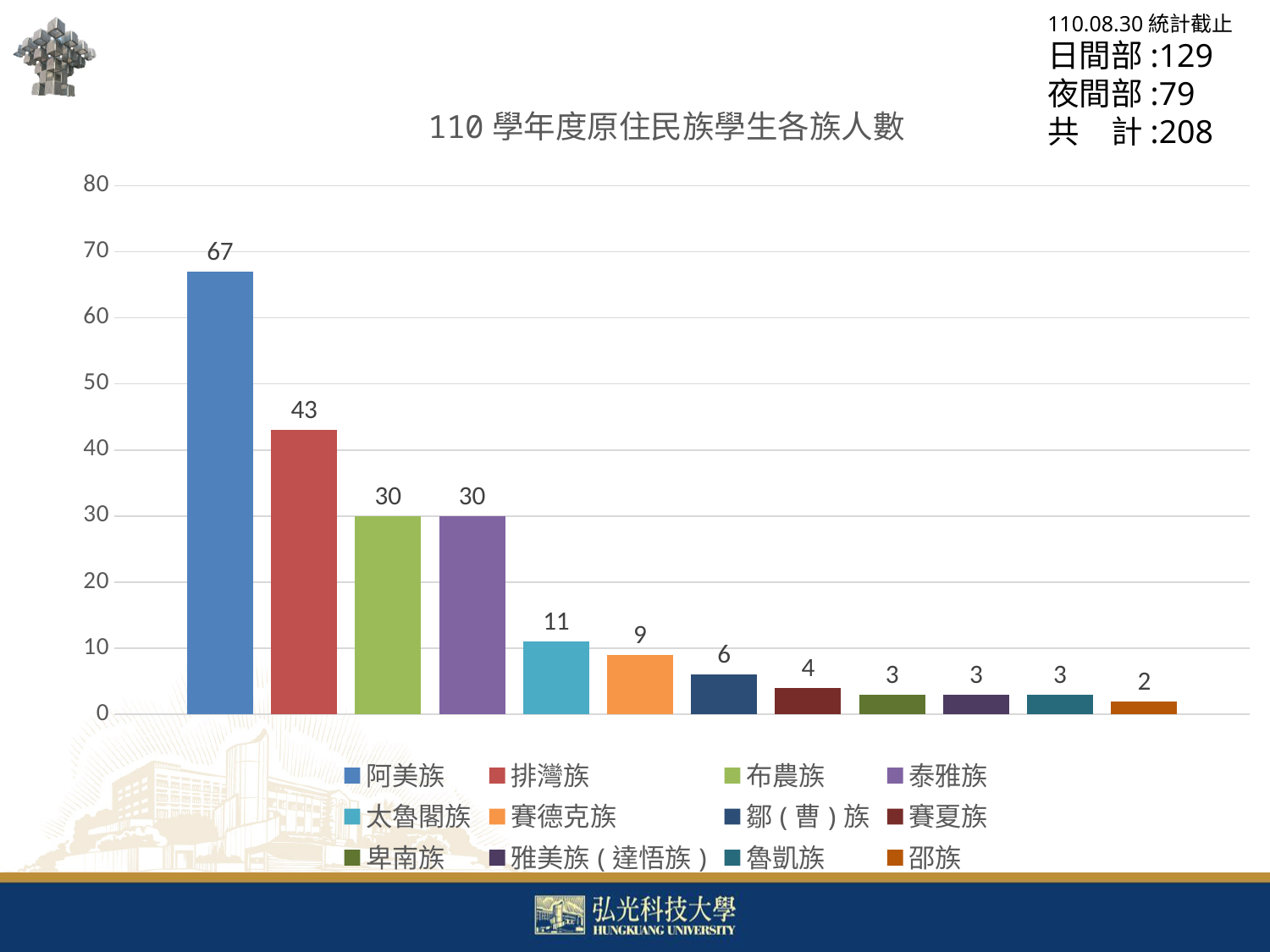
What is the value for 排灣族? 43 Which group has the highest value? 阿美族 What is the value for 太魯閣族? 11 What is the title of the chart? 110 學年度原住民族學生各族人數 How many bars are plotted in the chart? 12 What kind of chart is shown on the slide? Bar chart How many entries does the legend list? 12 What is the value for 阿美族? 67 Which group has the lowest value? 邵族 What is the value for 賽德克族? 9 What is the difference between the values for 阿美族 and 排灣族? 24 Which is larger, the value for 鄒(曹)族 or the value for 賽夏族? 鄒(曹)族